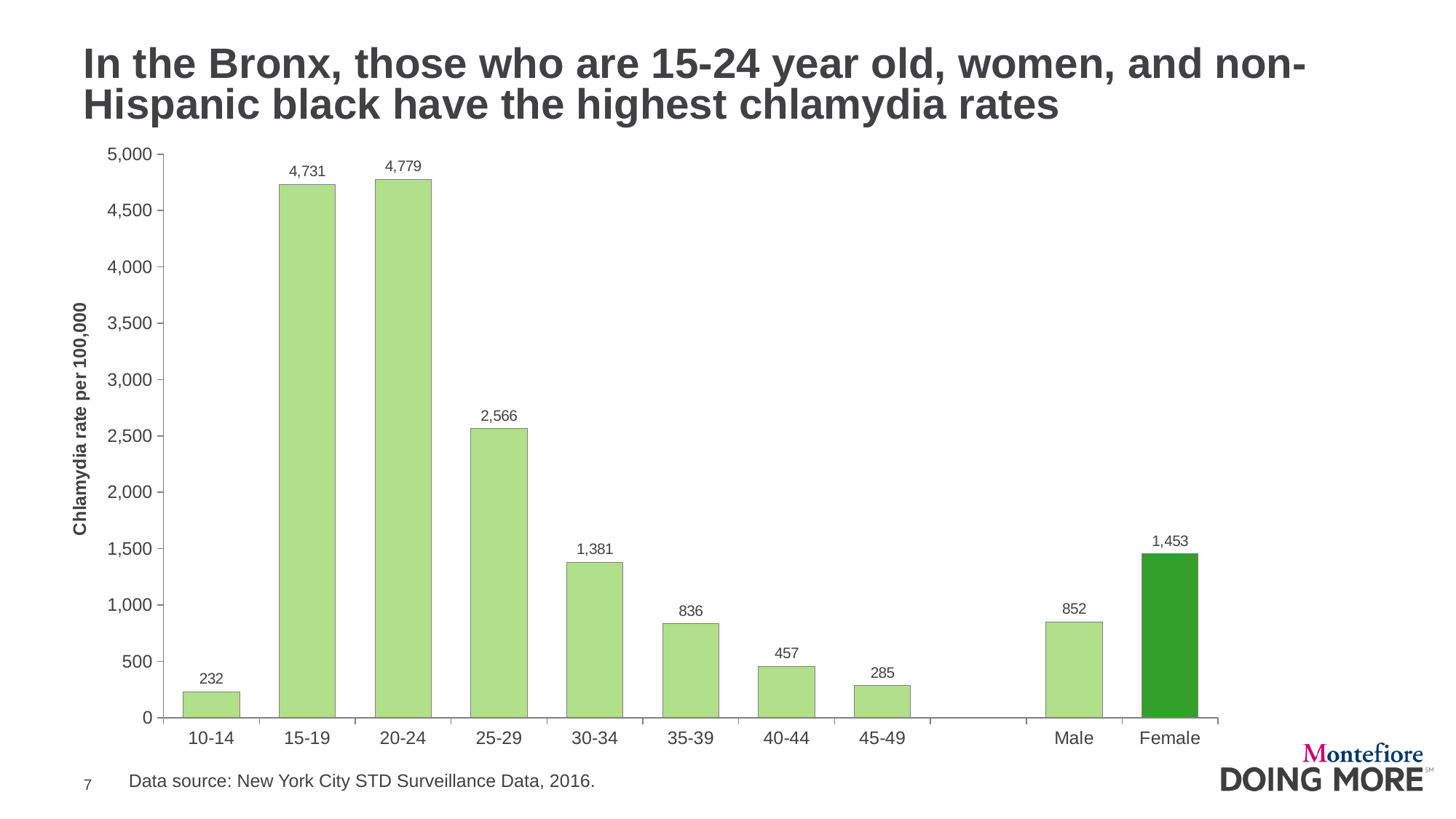
How many age-group categories are shown on the chart? 8 What is the difference between the female and male chlamydia rates? 601 What is the difference between the chlamydia rates for the 25-29 and 30-34 age groups? 1,185 What is the chlamydia rate per 100,000 for females? 1,453 Which age group has the lowest chlamydia rate? 10-14 Is the chlamydia rate for the 40-44 age group greater or less than 500? less What is the chlamydia rate per 100,000 for the 45-49 age group? 285 What is the chlamydia rate per 100,000 for the 20-24 age group? 4,779 What kind of chart is shown on the slide? Bar chart Which age group has the highest chlamydia rate? 20-24 What is the label on the vertical axis of the chart? Chlamydia rate per 100,000 Which has a higher chlamydia rate, the 35-39 age group or males? Male